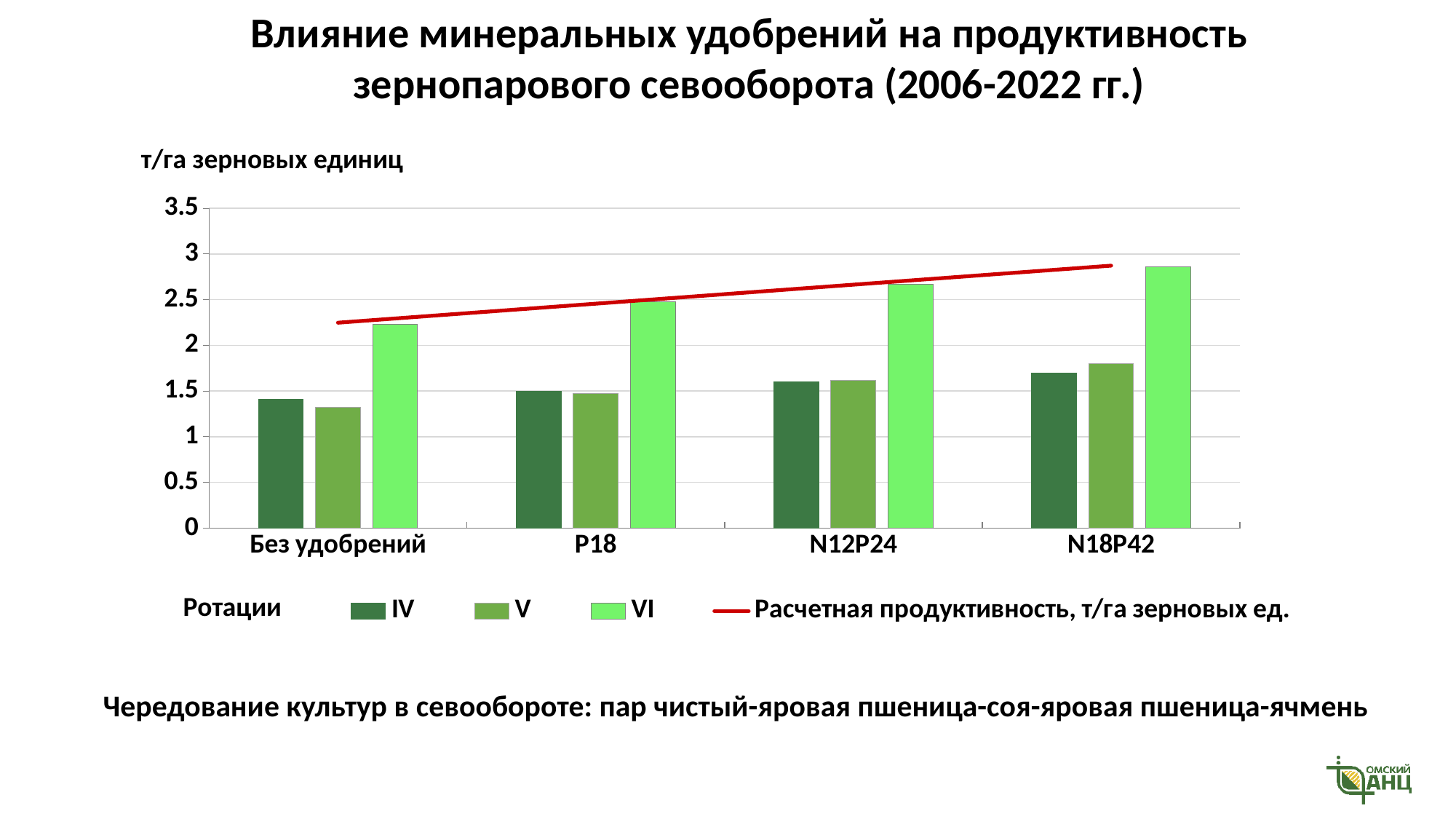
What unit is given above the y axis of the chart? т/га зерновых единиц Is the value for series IV at Без удобрений greater or less than 1.5? less Do the values for series VI rise or fall from Без удобрений to N18P42? rise Is the value for series VI at N18P42 greater or less than 2.5? greater What kind of chart is shown on the slide? bar chart Which category has the highest value for series VI? N18P42 Is the value for series V at N18P42 greater or less than 1.5? greater Which category has the lowest value for series V? Без удобрений How many entries does the legend list? 4 How many fertilizer categories are shown on the x axis? 4 At P18, which is larger: the value for series VI or the value for series IV? VI